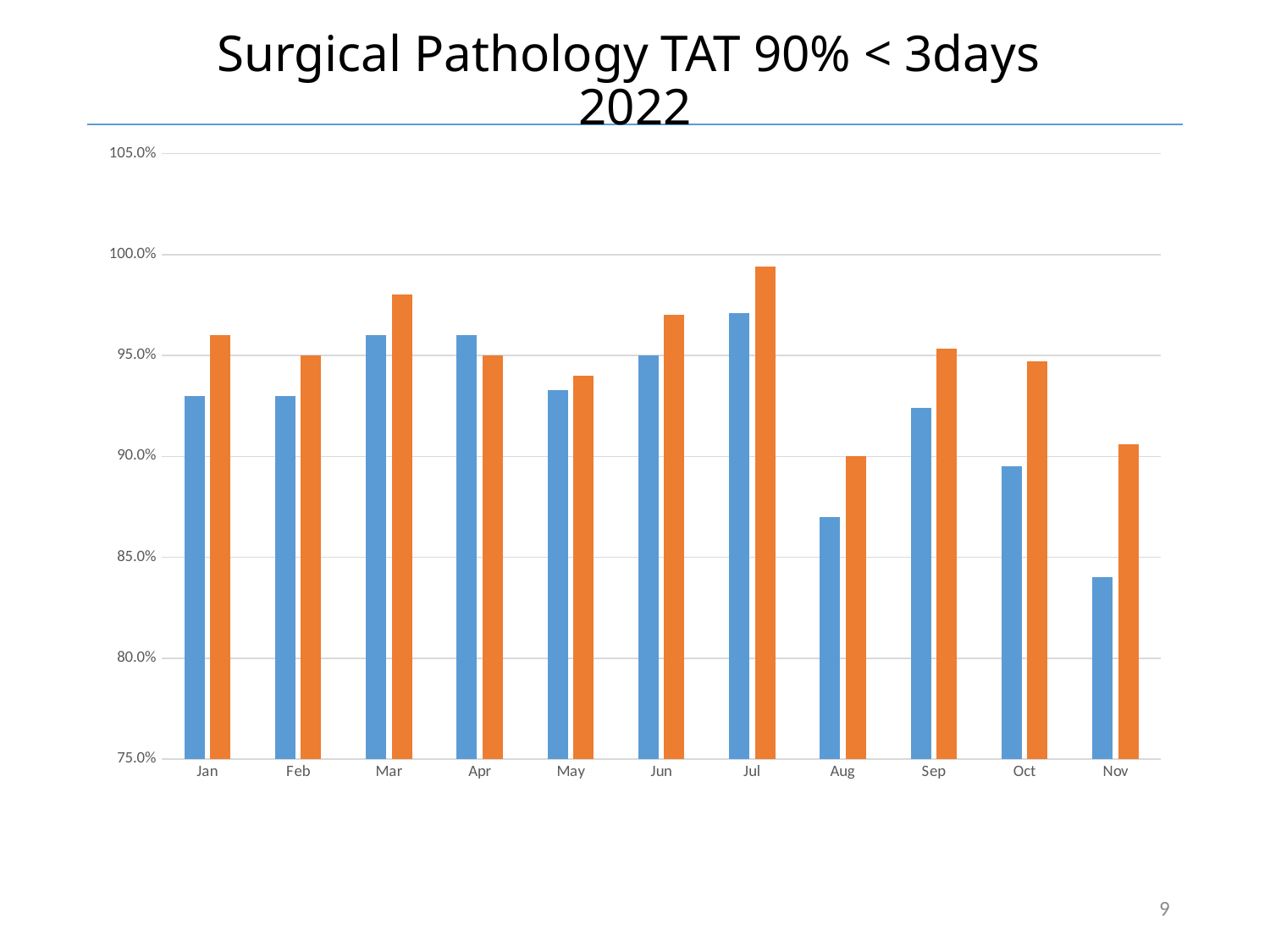
Is the value of the orange bar for Jul greater or less than 100.0%? less Which is larger, the orange bar for Aug or the orange bar for Jan? Jan In which month is the blue bar the highest? Jul How many months are shown on the x axis of the chart? 11 Is the value of the blue bar for Nov greater or less than 85.0%? less In which month is the orange bar the highest? Jul Which is larger, the blue bar for Jul or the blue bar for Nov? Jul Is the value of the blue bar for Aug greater or less than 90.0%? less What is the title of the chart on the slide? Surgical Pathology TAT 90% < 3days 2022 What type of chart is shown on the slide? bar chart In which month is the blue bar the lowest? Nov